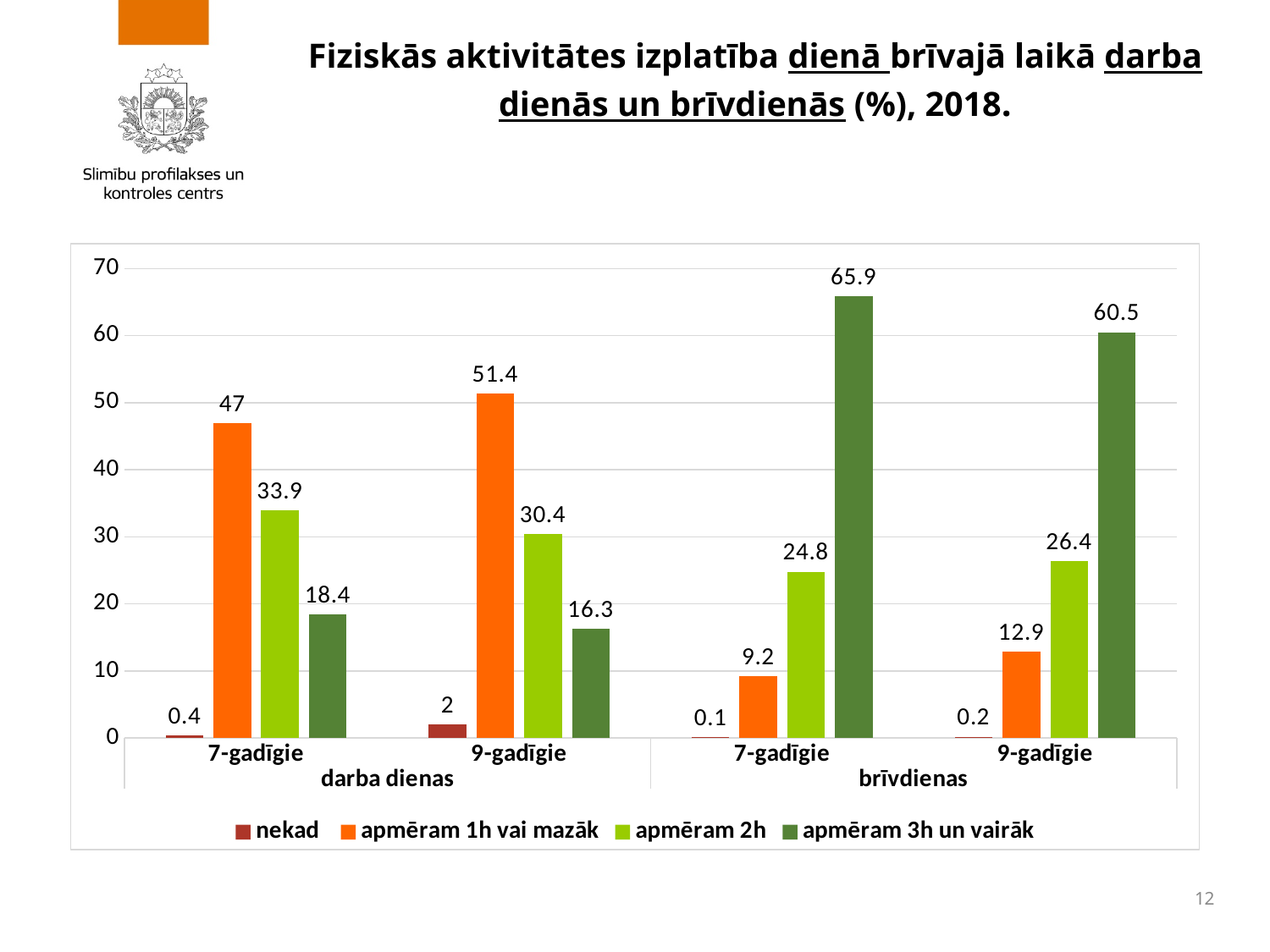
What is the value for "apmēram 1h vai mazāk" among 7-gadīgie on darba dienas? 47 What is the difference between the "apmēram 3h un vairāk" values for 7-gadīgie and 9-gadīgie on brīvdienas? 5.4 Is the value for "apmēram 1h vai mazāk" among 9-gadīgie on brīvdienas greater or less than 20? less What kind of chart is shown on the slide? bar chart Which is larger: "apmēram 2h" for 7-gadīgie on darba dienas or "apmēram 2h" for 9-gadīgie on darba dienas? 7-gadīgie on darba dienas Which series has the highest value among 9-gadīgie on darba dienas? apmēram 1h vai mazāk How many series does the legend list? 4 What is the value for "apmēram 3h un vairāk" among 7-gadīgie on brīvdienas? 65.9 What is the value for "apmēram 2h" among 9-gadīgie on brīvdienas? 26.4 What colour are the bars for "apmēram 3h un vairāk"? dark green Which series has the lowest value among 7-gadīgie on brīvdienas? nekad What is the value for "nekad" among 9-gadīgie on darba dienas? 2